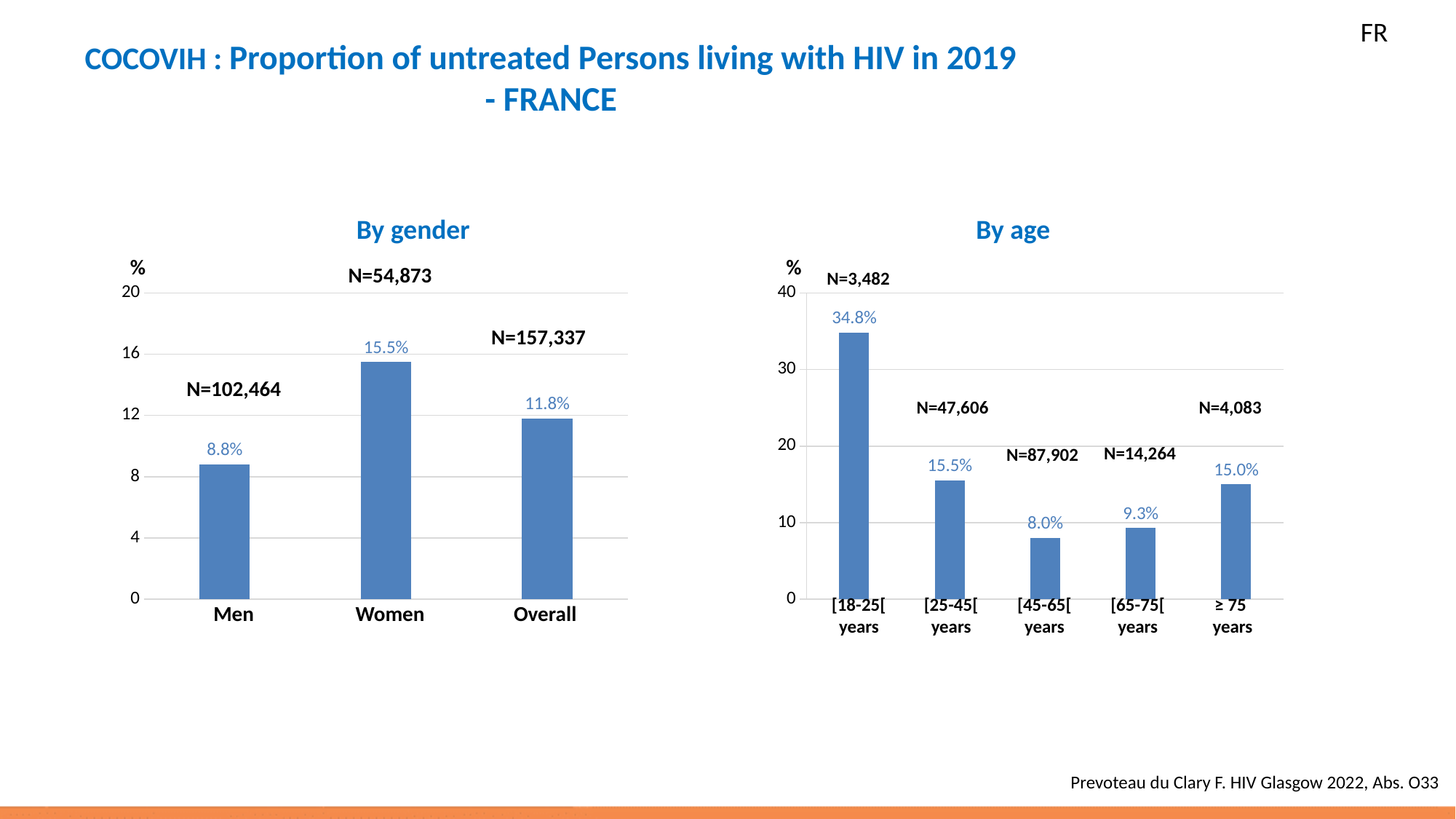
In the 'By gender' chart, what is the value for Men? 8.8% In the 'By age' chart, which age group has the lowest value? [45-65[ years In the 'By gender' chart, what is the difference between the values for Women and Men? 6.7% In the 'By age' chart, is the value for [18-25[ years greater or less than 30? greater In the 'By age' chart, which is larger, the value for [65-75[ years or the value for ≥ 75 years? ≥ 75 years In the 'By gender' chart, what is the N value shown above the Overall bar? N=157,337 In the 'By gender' chart, which category has the highest value? Women What kind of chart is the 'By age' chart? Bar chart In the 'By gender' chart, how many categories are shown on the x axis? 3 In the 'By gender' chart, what is the value for Women? 15.5% In the 'By age' chart, how many age groups are shown? 5 In the 'By age' chart, what is the value for [18-25[ years? 34.8%